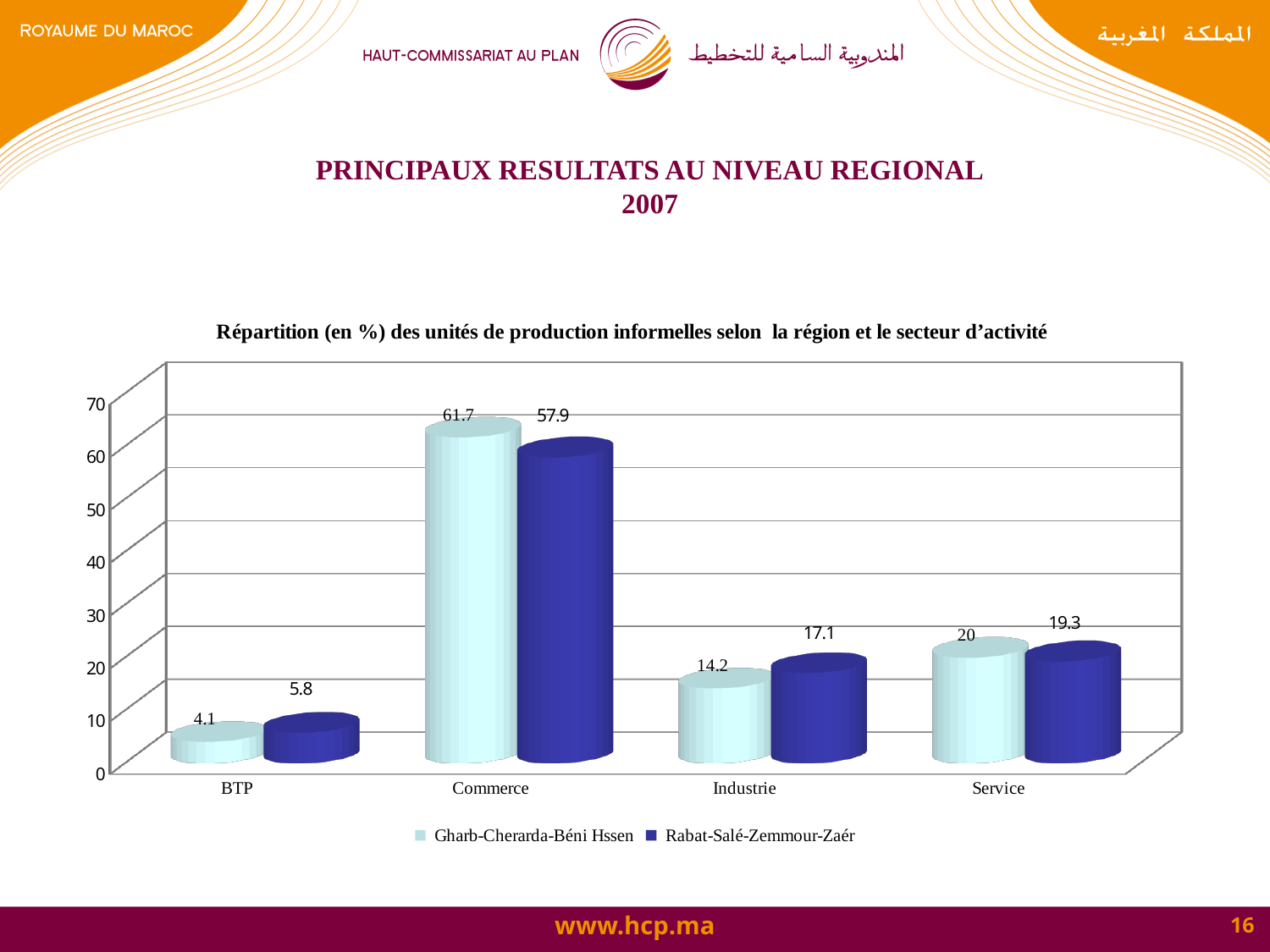
What is the value for Industrie in the Rabat-Salé-Zemmour-Zaér series? 17.1 What is the value for Service in the Rabat-Salé-Zemmour-Zaér series? 19.3 Which sector has the highest value in the Rabat-Salé-Zemmour-Zaér series? Commerce What is the value for Commerce in the Gharb-Cherarda-Béni Hssen series? 61.7 What is the value for BTP in the Gharb-Cherarda-Béni Hssen series? 4.1 Which sector has the lowest value in the Gharb-Cherarda-Béni Hssen series? BTP Is the value for Service in the Gharb-Cherarda-Béni Hssen series greater or less than 30? less What kind of chart is shown on the slide? bar chart How many sectors are shown on the x axis? 4 What is the difference between the two regions' values for Commerce? 3.8 For BTP, which region has the larger value? Rabat-Salé-Zemmour-Zaér How many series does the legend list? 2